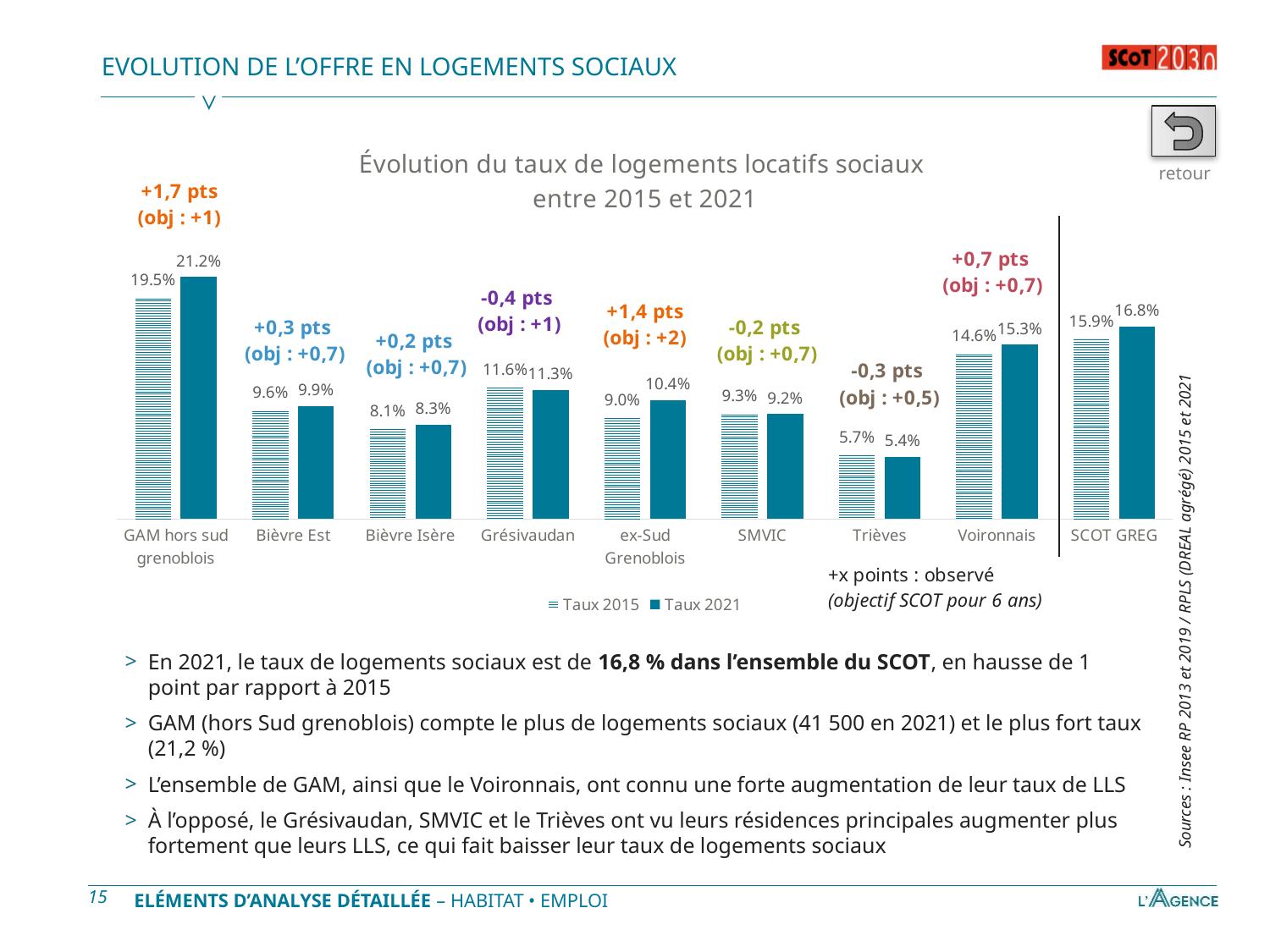
Which is larger for Grésivaudan: the Taux 2015 value or the Taux 2021 value? Taux 2015 Which category has the lowest Taux 2015 value? Trièves Which category has the highest Taux 2021 value? GAM hors sud grenoblois What is the Taux 2021 value for GAM hors sud grenoblois? 21.2% What is the Taux 2015 value for Trièves? 5.7% How many series does the legend list? 2 What kind of chart is shown on the slide? Bar chart What is the Taux 2021 value for SCOT GREG? 16.8% How many categories are shown on the x axis of the chart? 9 What is the title of the chart? Évolution du taux de logements locatifs sociaux entre 2015 et 2021 What is the difference between the Taux 2021 and Taux 2015 values for ex-Sud Grenoblois? 1.4% What is the Taux 2015 value for Voironnais? 14.6%